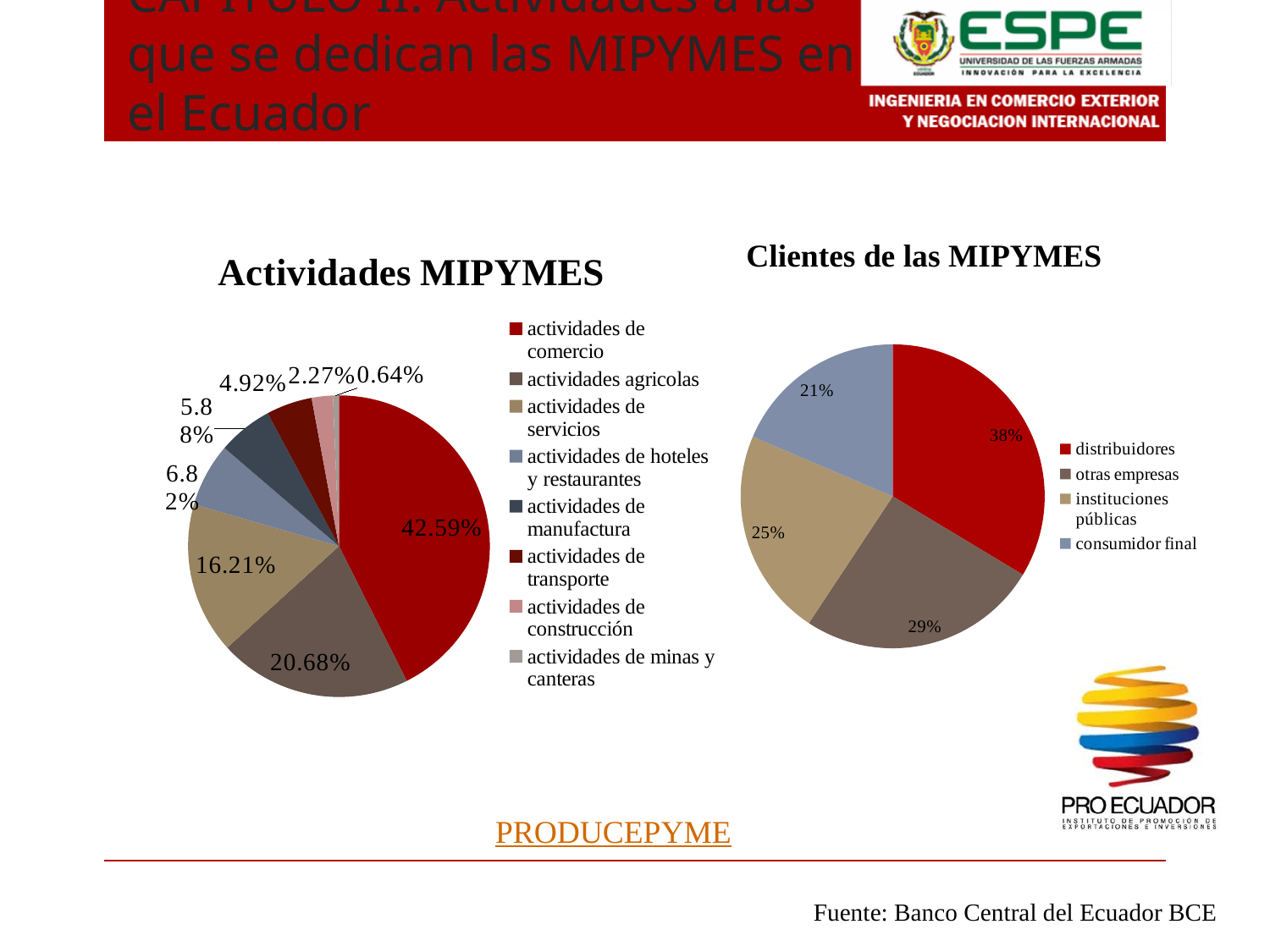
In the 'Actividades MIPYMES' chart, how many activity categories does the legend list? 8 In the 'Actividades MIPYMES' chart, which activity has the largest share? actividades de comercio What type of chart is 'Clientes de las MIPYMES'? pie chart In the 'Actividades MIPYMES' chart, what is the difference between the shares of actividades de comercio and actividades agricolas? 21.91% In the 'Clientes de las MIPYMES' chart, what percentage corresponds to distribuidores? 38% In the 'Actividades MIPYMES' chart, what percentage corresponds to actividades agricolas? 20.68% In the 'Actividades MIPYMES' chart, which activity has the smallest share? actividades de minas y canteras In the 'Actividades MIPYMES' chart, what percentage corresponds to actividades de comercio? 42.59% In the 'Clientes de las MIPYMES' chart, what percentage corresponds to instituciones públicas? 25% In the 'Clientes de las MIPYMES' chart, which is larger: otras empresas or consumidor final? otras empresas In the 'Clientes de las MIPYMES' chart, which client type has the smallest share? consumidor final In the 'Actividades MIPYMES' chart, what percentage corresponds to actividades de servicios? 16.21%